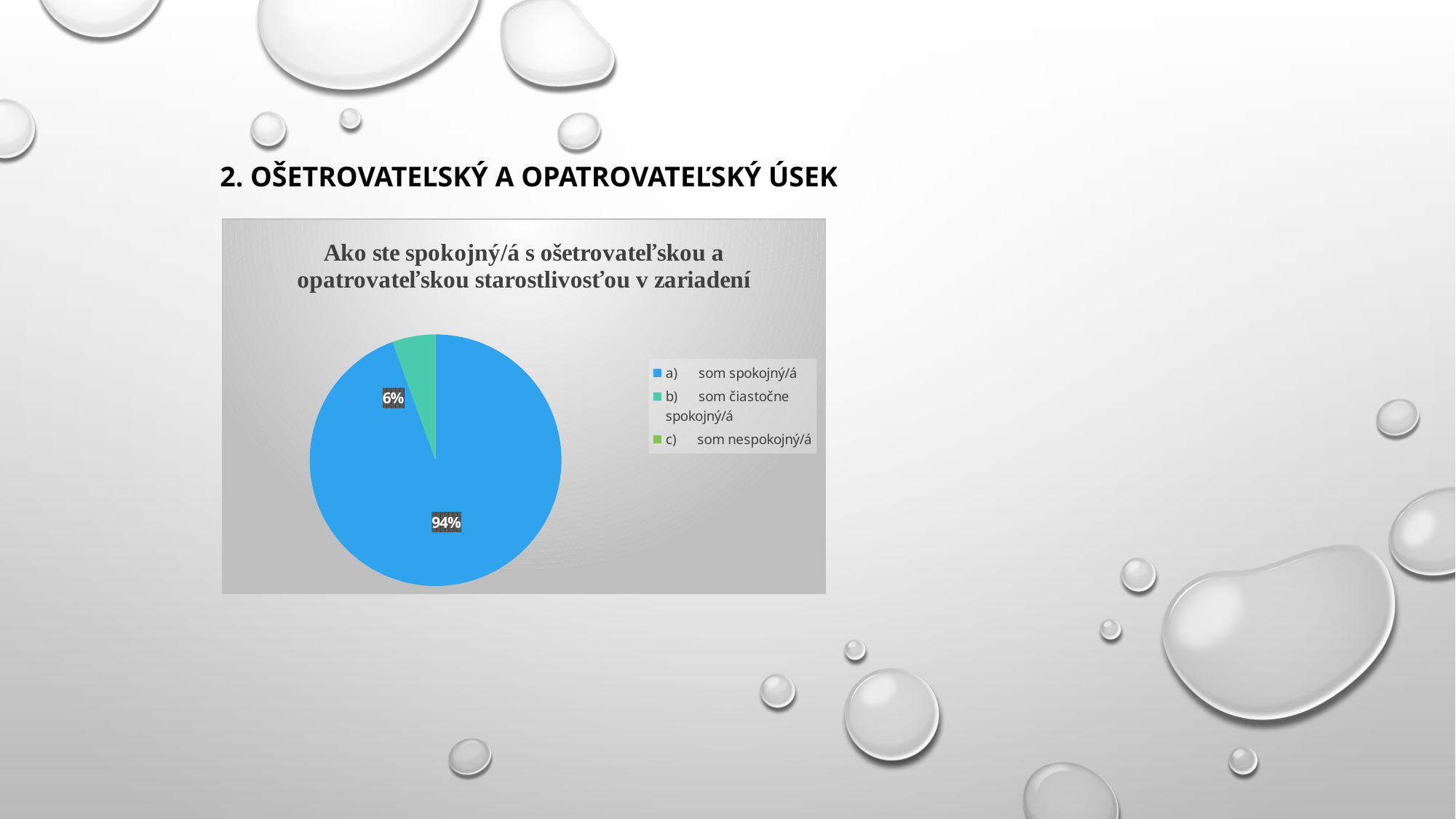
How many entries does the legend list? 3 By how many percentage points does "a) som spokojný/á" exceed "b) som čiastočne spokojný/á"? 88 percentage points What kind of chart is shown on the slide? pie chart What colour is the slice for "a) som spokojný/á"? blue Is the share for "a) som spokojný/á" greater or less than 50%? greater What is the title of the pie chart? Ako ste spokojný/á s ošetrovateľskou a opatrovateľskou starostlivosťou v zariadení Which is larger, the slice for "a) som spokojný/á" or the slice for "b) som čiastočne spokojný/á"? a) som spokojný/á Which response has the largest slice of the pie? a) som spokojný/á What percentage of respondents answered "a) som spokojný/á"? 94% What percentage of respondents answered "b) som čiastočne spokojný/á"? 6% What share of the pie does "b) som čiastočne spokojný/á" take? 6%